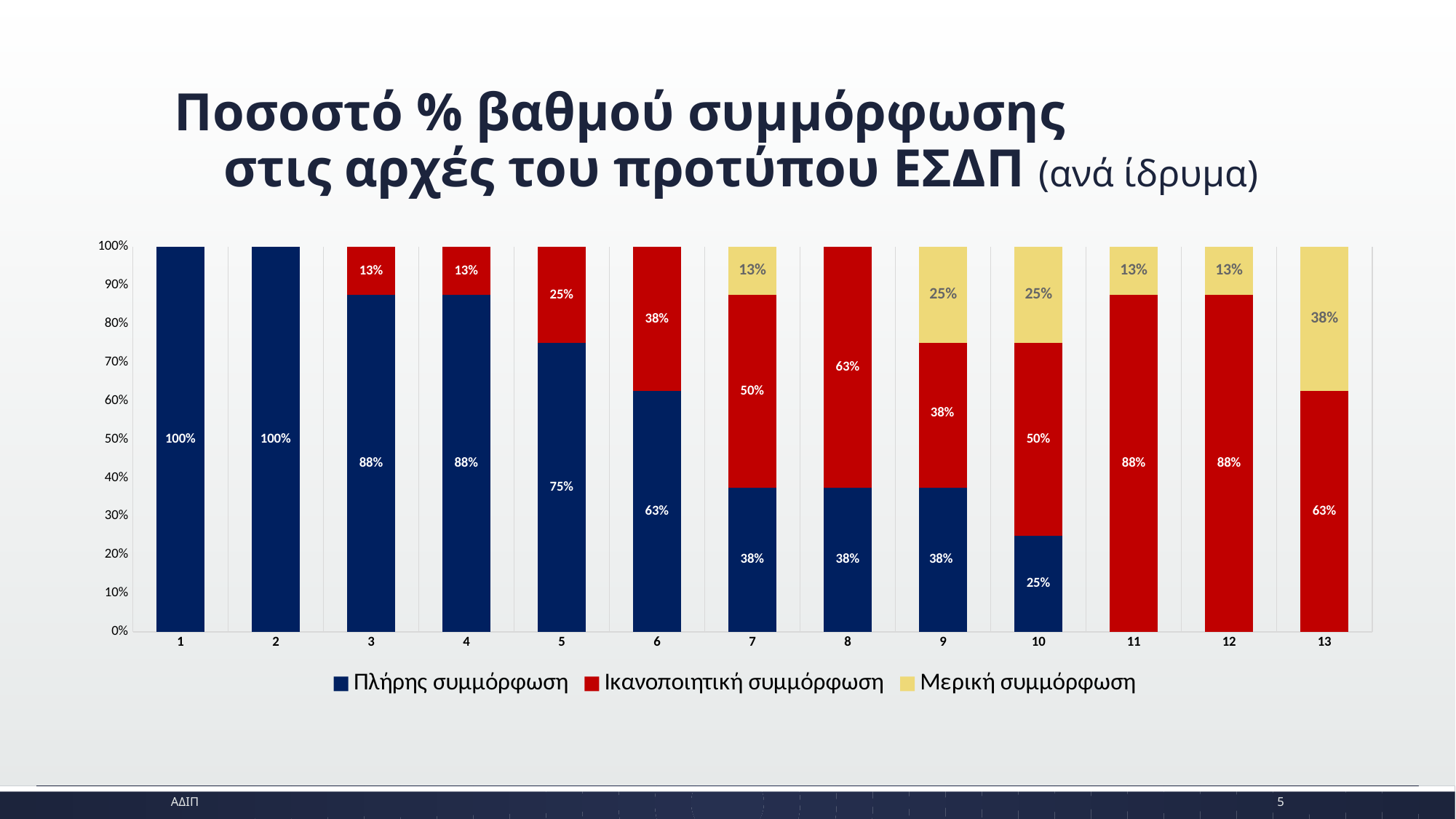
What is the value of Ικανοποιητική συμμόρφωση for institution 8? 63% What is the value of Πλήρης συμμόρφωση for institution 5? 75% Which institution has the lowest value for Ικανοποιητική συμμόρφωση among those with a labelled red segment? 3 and 4 (13%) Which is larger: the Πλήρης συμμόρφωση value for institution 3 or for institution 7? Institution 3 How many institutions are shown on the x axis? 13 Which colour represents Μερική συμμόρφωση in the legend? Yellow What is the value of Ικανοποιητική συμμόρφωση for institution 13? 63% What is the value of Μερική συμμόρφωση for institution 10? 25% What is the difference between the Πλήρης συμμόρφωση values for institutions 5 and 6? 12 percentage points What kind of chart is shown on the slide? Stacked bar chart How many series does the legend list? 3 Which institution has the highest value for Μερική συμμόρφωση? 13